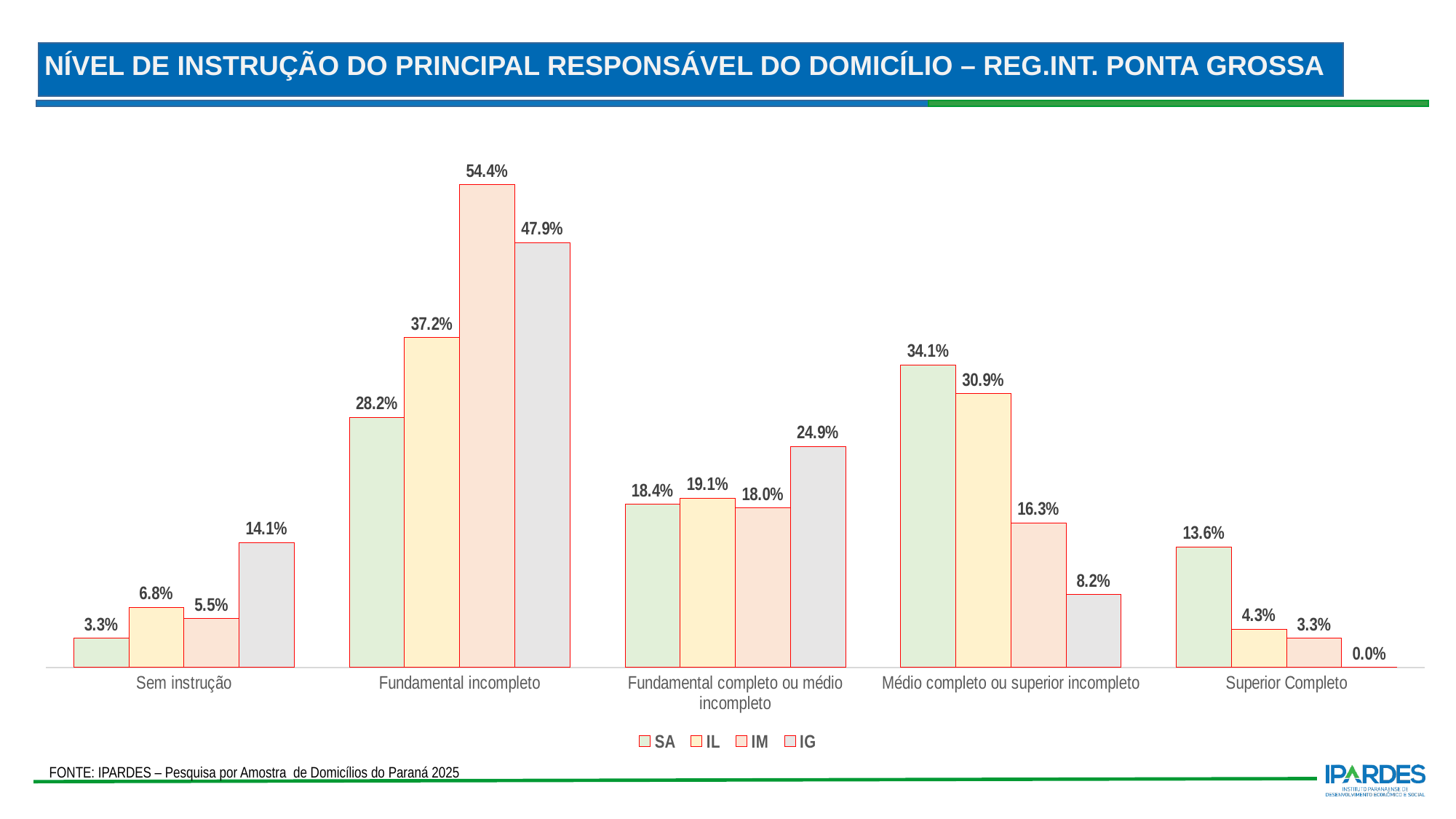
What is the difference between the SA and IL values in the Superior Completo category? 9.3% What is the difference between the IM and IG values in the Fundamental incompleto category? 6.5% What is the value for SA in the Superior Completo category? 13.6% How many series does the legend list? 4 What is the value for IG in the Sem instrução category? 14.1% Which series has the lowest value in the Superior Completo category? IG What are the series names listed in the legend? SA, IL, IM, IG How many categories are shown on the x axis? 5 Which series has the highest value in the Médio completo ou superior incompleto category? SA What is the value for IM in the Fundamental incompleto category? 54.4% What kind of chart is shown on the slide? Bar chart Which is larger in the Fundamental completo ou médio incompleto category, the IG value or the SA value? IG